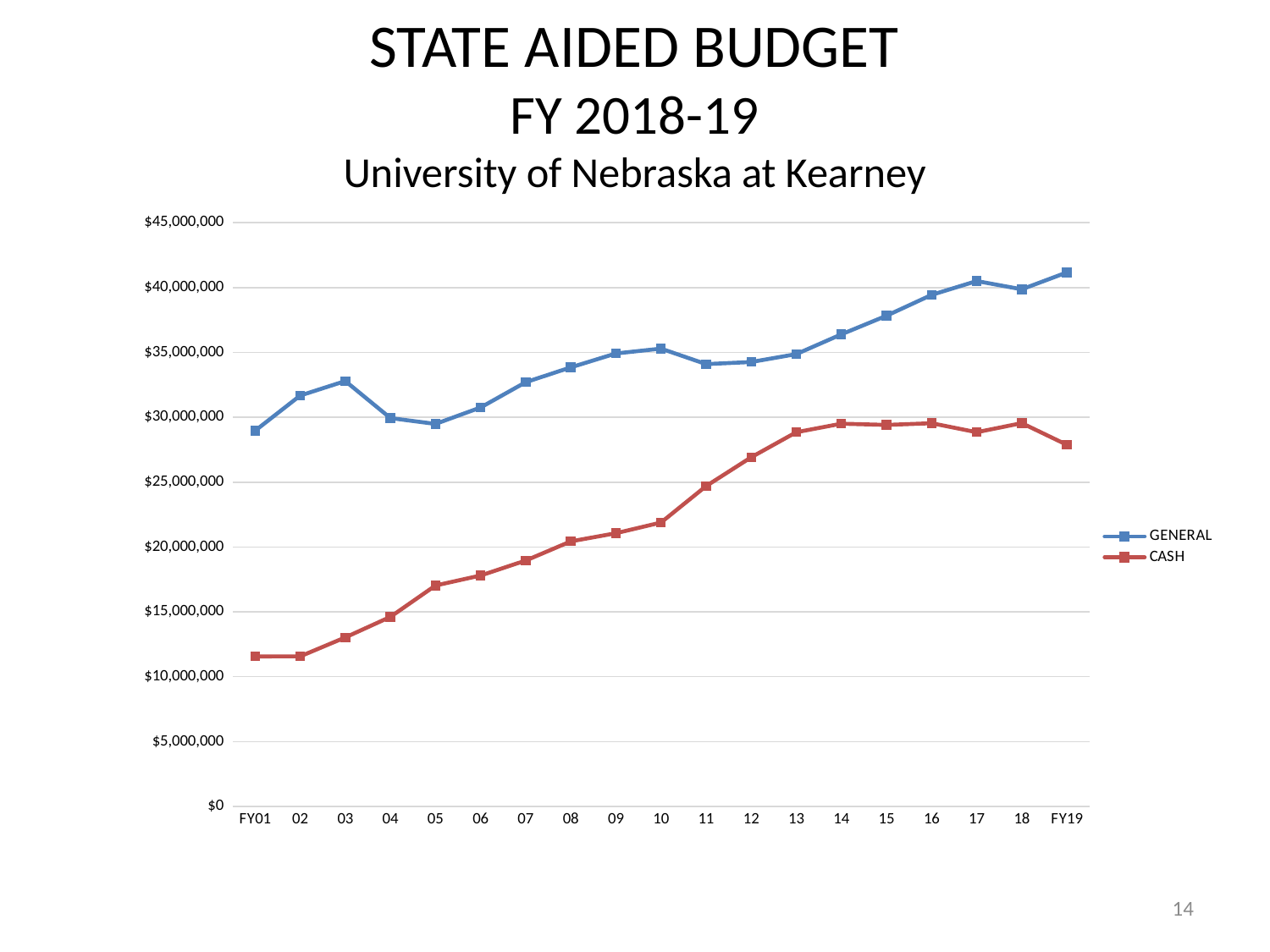
Is the CASH value for FY19 greater or less than $30,000,000? less Is the GENERAL value for FY19 greater or less than $40,000,000? greater In FY10, which series has the larger value, GENERAL or CASH? GENERAL Does the CASH line rise or fall from FY01 to FY13? rises Is the CASH value for FY01 greater or less than $15,000,000? less What kind of chart is shown on the slide? line chart How many series does the legend list? 2 In which fiscal year is the GENERAL value highest? FY19 How many fiscal years are plotted along the x axis? 19 Which two series are listed in the legend? GENERAL and CASH What colour is the CASH line? red